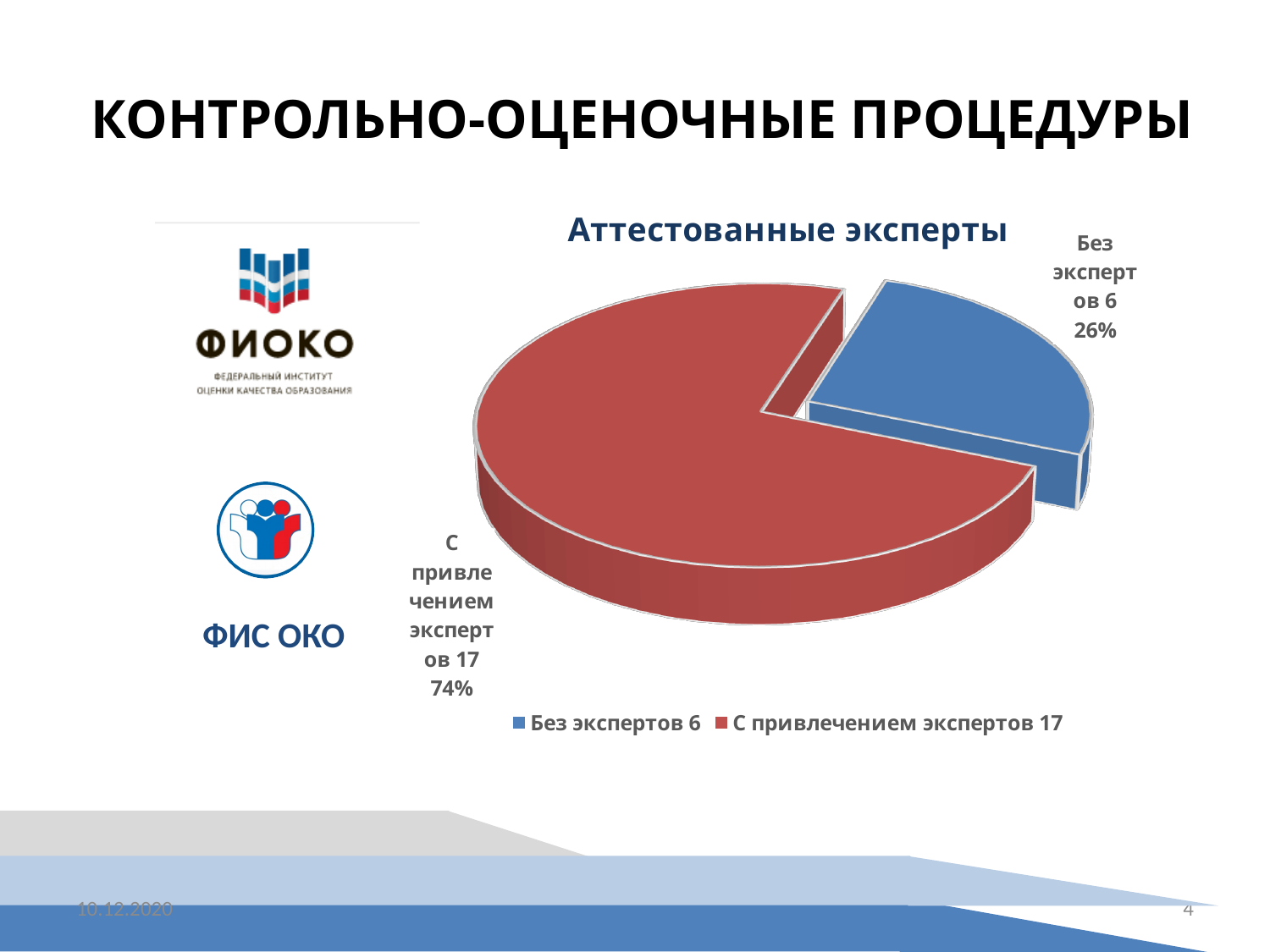
What kind of chart is shown on the slide? Pie chart What percentage share does the slice "С привлечением экспертов" have? 74% What is the value shown for "С привлечением экспертов"? 17 Which slice is the smallest? Без экспертов What is the title of the chart? Аттестованные эксперты What percentage share does the slice "Без экспертов" have? 26% What is the value shown for "Без экспертов"? 6 What is the difference between the values for "С привлечением экспертов" and "Без экспертов"? 11 Which colour represents the slice "Без экспертов"? Blue How many slices does the pie chart have? 2 Which slice is the largest? С привлечением экспертов How many entries does the legend list? 2